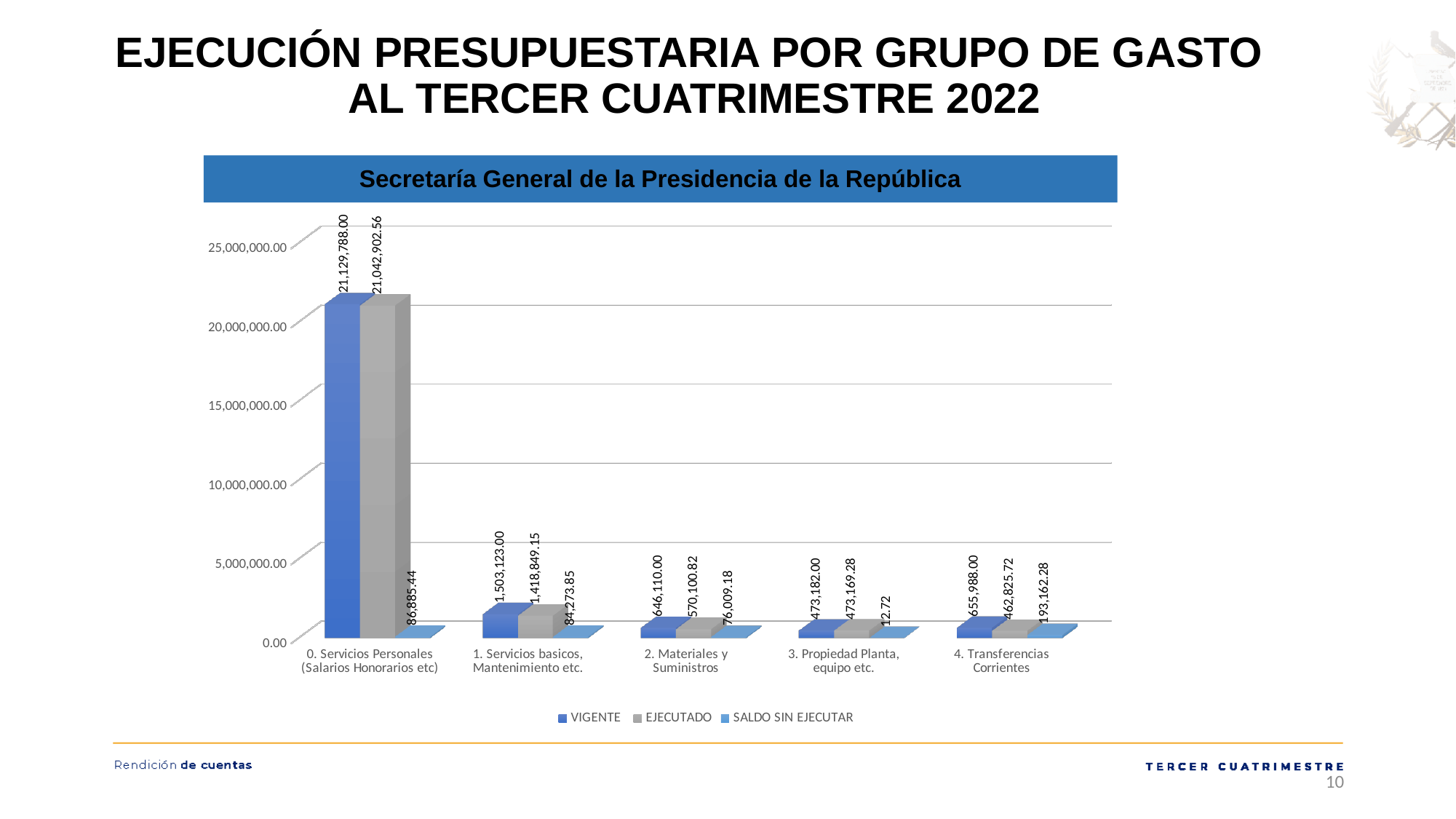
How many series does the legend list? 3 What is the EJECUTADO value for 3. Propiedad Planta, equipo etc.? 473,169.28 Which category has the highest VIGENTE value? 0. Servicios Personales (Salarios Honorarios etc) What is the difference between the VIGENTE and EJECUTADO values for 2. Materiales y Suministros? 76,009.18 Which category has the lowest SALDO SIN EJECUTAR value? 3. Propiedad Planta, equipo etc. What is the VIGENTE value for 0. Servicios Personales (Salarios Honorarios etc)? 21,129,788.00 What is the EJECUTADO value for 1. Servicios basicos, Mantenimiento etc.? 1,418,849.15 Is the VIGENTE value for 0. Servicios Personales (Salarios Honorarios etc) greater or less than 20,000,000.00? greater Which is larger, the VIGENTE value for 4. Transferencias Corrientes or the VIGENTE value for 2. Materiales y Suministros? 4. Transferencias Corrientes What is the SALDO SIN EJECUTAR value for 4. Transferencias Corrientes? 193,162.28 What kind of chart is shown on the slide? Bar chart How many categories are shown on the x axis? 5